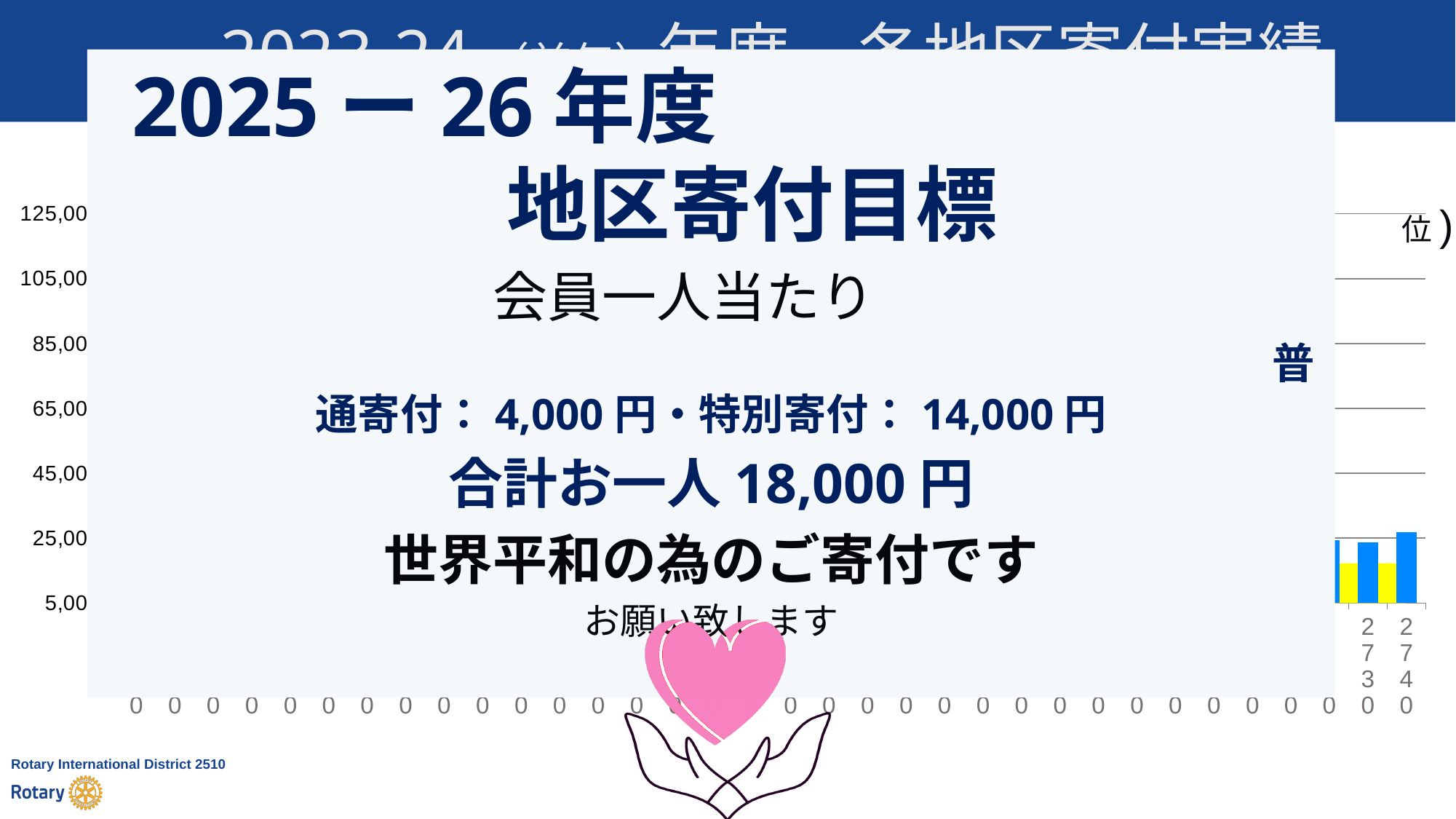
What kind of chart is shown on the slide? combination bar and area chart For category 2740, which bar is taller, the blue bar or the yellow bar? the blue bar What two colours are used for the bars in the chart? blue and yellow For category 2730, which bar is taller, the blue bar or the yellow bar? the blue bar